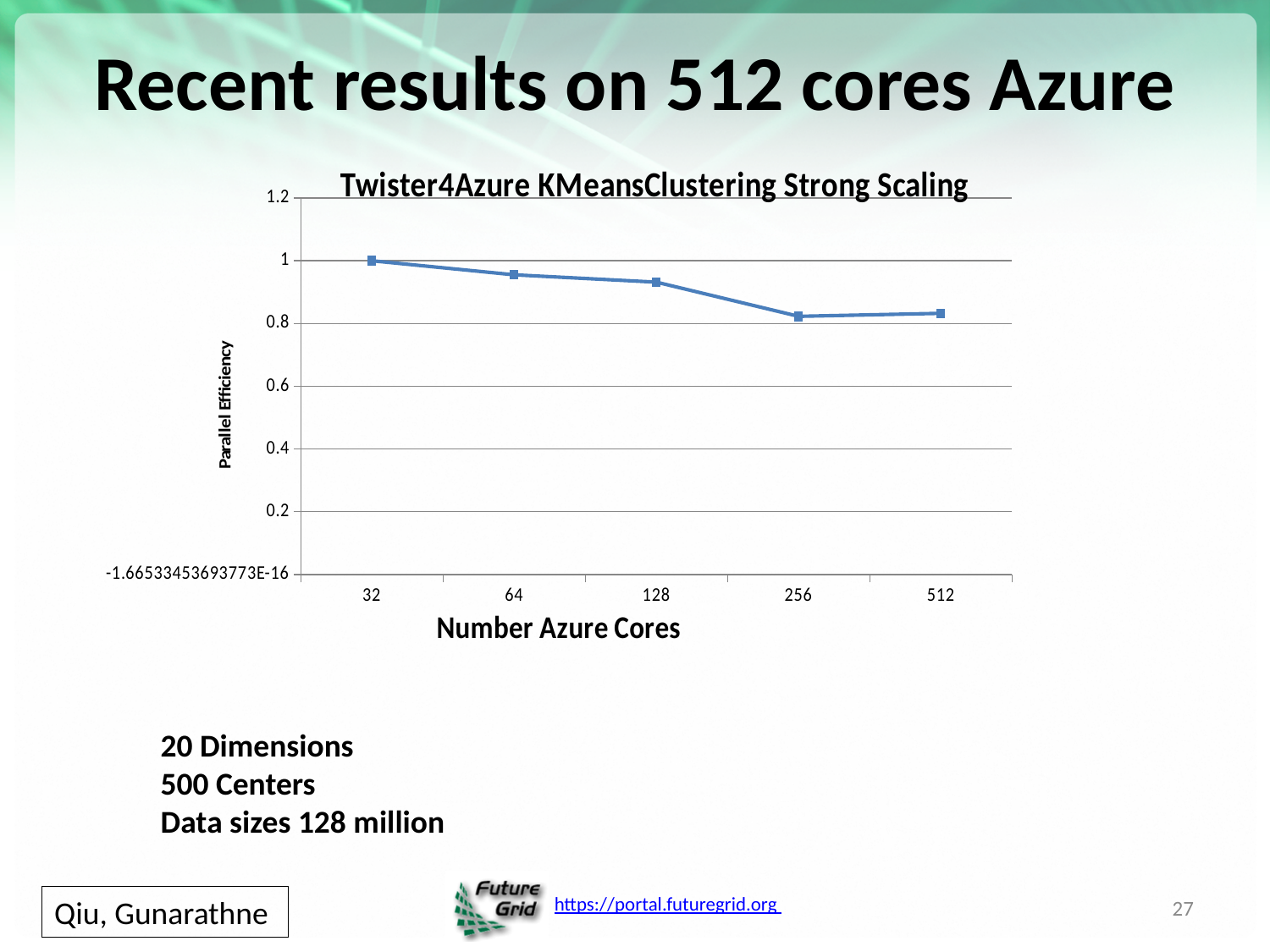
Is the parallel efficiency at 64 cores greater or less than 1? less What kind of chart is shown on the slide? line chart Is the parallel efficiency at 128 cores greater or less than 0.8? greater What is the parallel efficiency at 32 Azure cores? 1 Which has a higher parallel efficiency, 64 cores or 256 cores? 64 cores Is the parallel efficiency at 512 cores greater or less than 0.6? greater At which number of Azure cores is the parallel efficiency highest? 32 Does the parallel efficiency generally rise or fall as the number of Azure cores increases? fall Which has a higher parallel efficiency, 128 cores or 512 cores? 128 cores How many data points are plotted on the chart? 5 What is the label of the x axis of the chart? Number Azure Cores What is the title of the chart? Twister4Azure KMeansClustering Strong Scaling